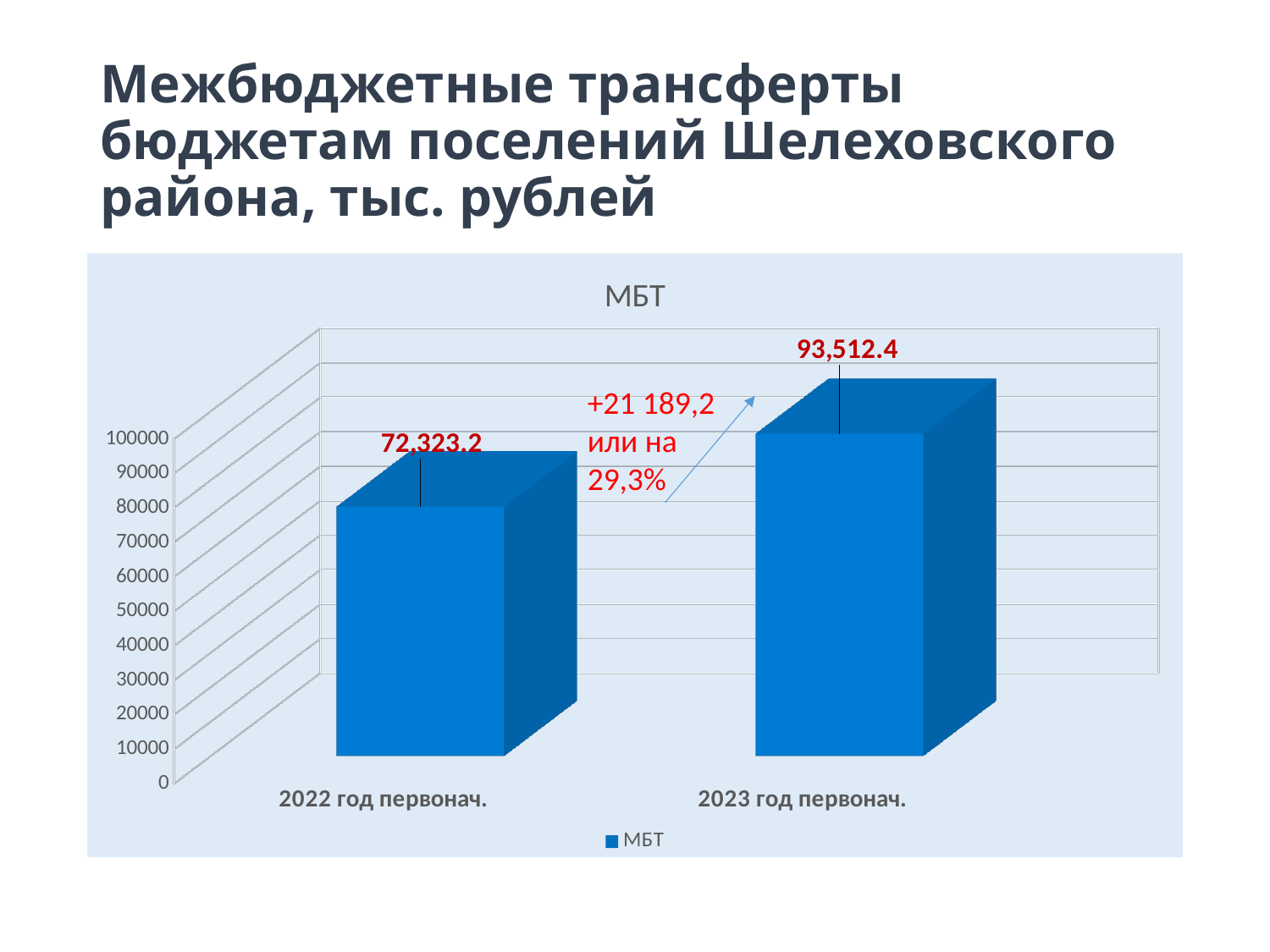
Which category has the highest value? 2023 год первонач. How many series does the legend list? 1 What is the value for 2022 год первонач.? 72,323.2 What is the difference between the values for 2023 год первонач. and 2022 год первонач.? 21,189.2 What is the title of the chart? МБТ Which category has the lowest value? 2022 год первонач. Do the values rise or fall from 2022 to 2023? rise What kind of chart is shown? bar chart How many categories are shown on the x axis? 2 What is the value for 2023 год первонач.? 93,512.4 Is the value for 2022 год первонач. greater or less than 80000? less Which is larger, the value for 2022 год первонач. or 2023 год первонач.? 2023 год первонач.